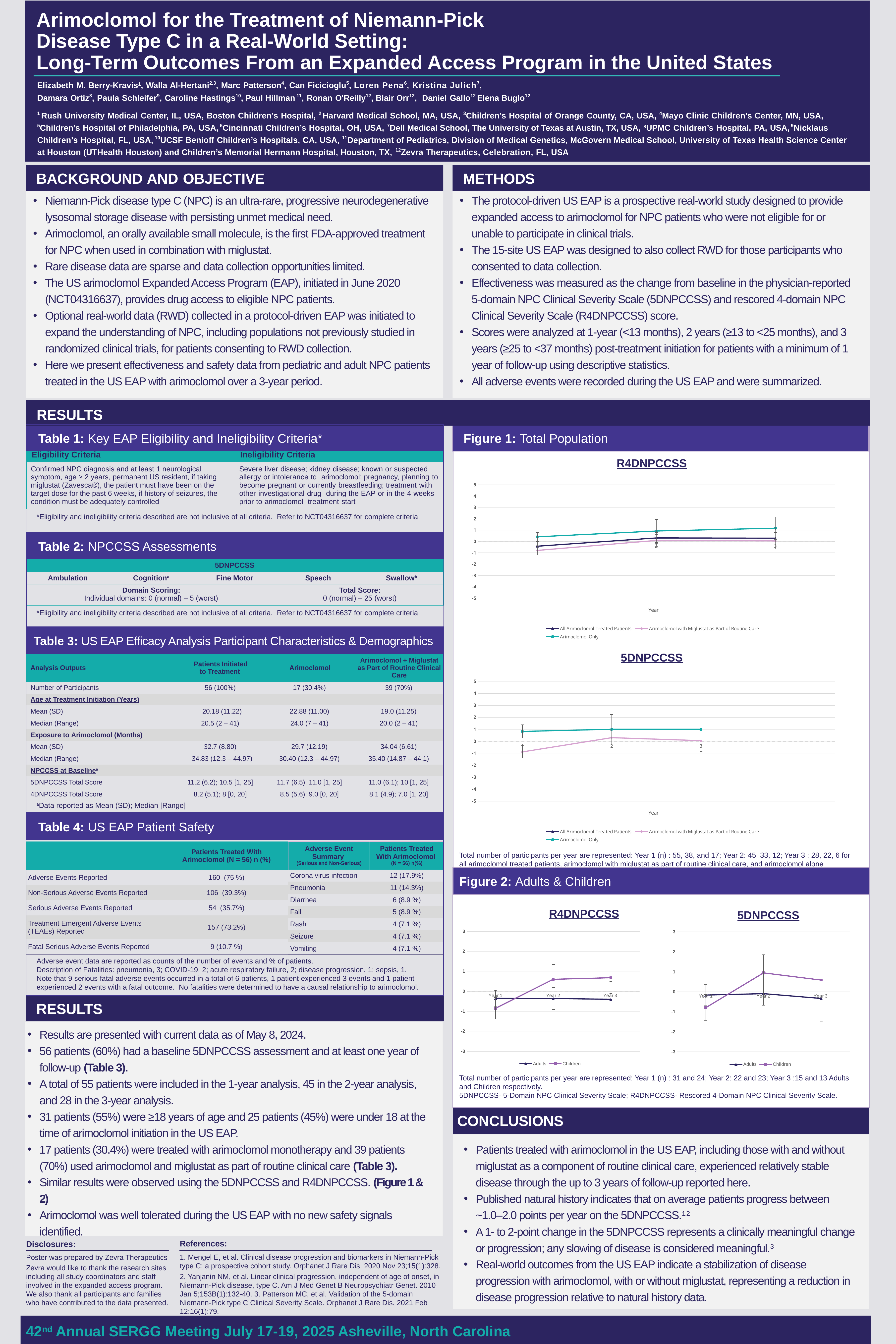
In the R4DNPCCSS chart of Figure 2: Adults & Children, which series has the higher value at Year 2: Adults or Children? Children What kind of chart is the R4DNPCCSS chart in Figure 1: Total Population? Line chart How many series does the legend list for the 5DNPCCSS chart in Figure 1: Total Population? 3 In the R4DNPCCSS chart of Figure 1: Total Population, does the Arimoclomol Only line rise or fall from Year 1 to Year 3? Rise How many time points are plotted along the x axis of the 5DNPCCSS chart in Figure 2: Adults & Children? 3 In the 5DNPCCSS chart of Figure 1: Total Population, is the value for Arimoclomol Only at Year 1 greater or less than 0? greater In the R4DNPCCSS chart of Figure 2: Adults & Children, is the value for Children at Year 2 greater or less than 0? greater In the R4DNPCCSS chart of Figure 2: Adults & Children, is the value for Children at Year 1 greater or less than 0? less What is the title of the figure containing the Adults and Children line charts? Figure 2: Adults & Children How many series does the legend list for the R4DNPCCSS chart in Figure 2: Adults & Children? 2 In the 5DNPCCSS chart of Figure 1: Total Population, which series has the higher value at Year 1: Arimoclomol Only or Arimoclomol with Miglustat as Part of Routine Care? Arimoclomol Only